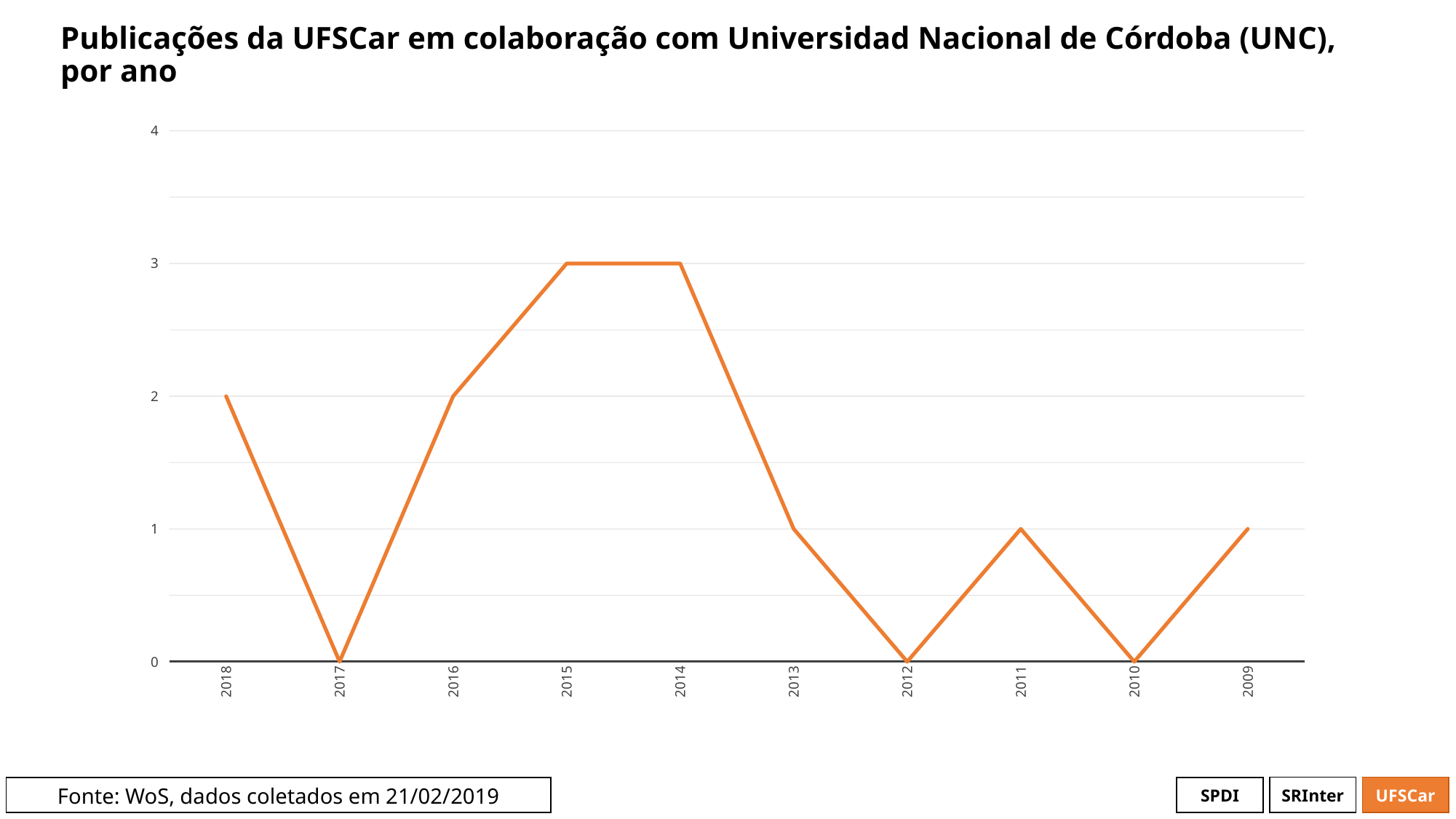
What is the value for 2018? 2 What is the highest value reached by the line? 3 What is the value for 2017? 0 What kind of chart is shown on the slide? line chart Is the value for 2014 greater or less than 2? greater What is the difference between the values for 2015 and 2013? 2 What is the value for 2015? 3 What is the value for 2009? 1 What is the value for 2013? 1 How many years are plotted on the x axis? 10 Does the line rise or fall between 2017 and 2015? rise Which year has the larger value, 2016 or 2013? 2016